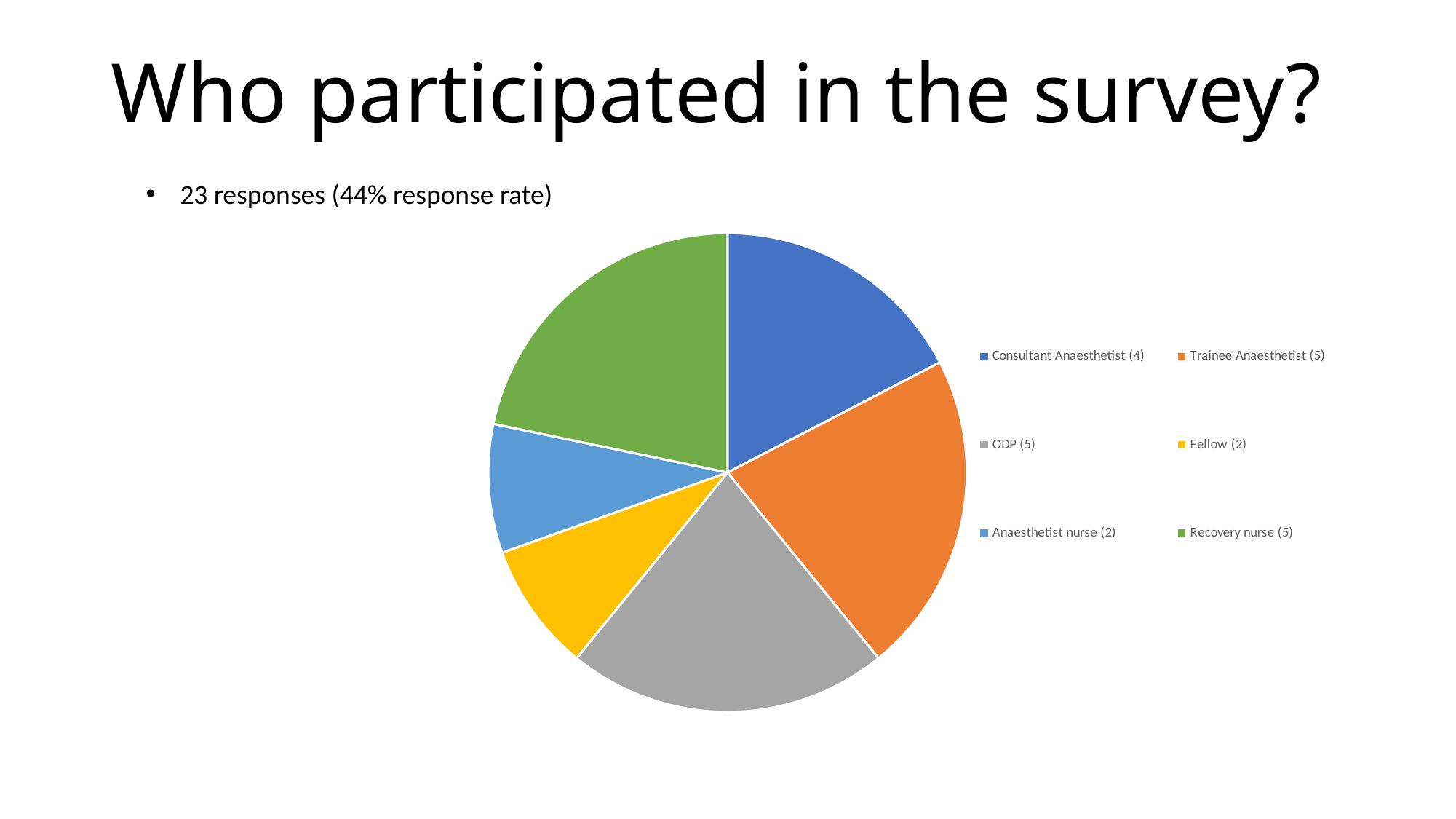
What type of chart is shown on the slide? pie chart How many categories does the pie chart show? 6 How many Trainee Anaesthetists participated according to the pie chart legend? 5 Which group had more participants, ODP or Anaesthetist nurse? ODP What colour represents Recovery nurse in the pie chart? green Which group had more participants, Consultant Anaesthetist or Fellow? Consultant Anaesthetist How many Fellows participated according to the pie chart legend? 2 What is the total number of survey responses shown on the slide? 23 How many Consultant Anaesthetists participated in the survey according to the pie chart legend? 4 How many Anaesthetist nurses participated according to the pie chart legend? 2 How many Recovery nurses participated according to the pie chart legend? 5 What is the difference between the number of Trainee Anaesthetists and the number of Fellows? 3